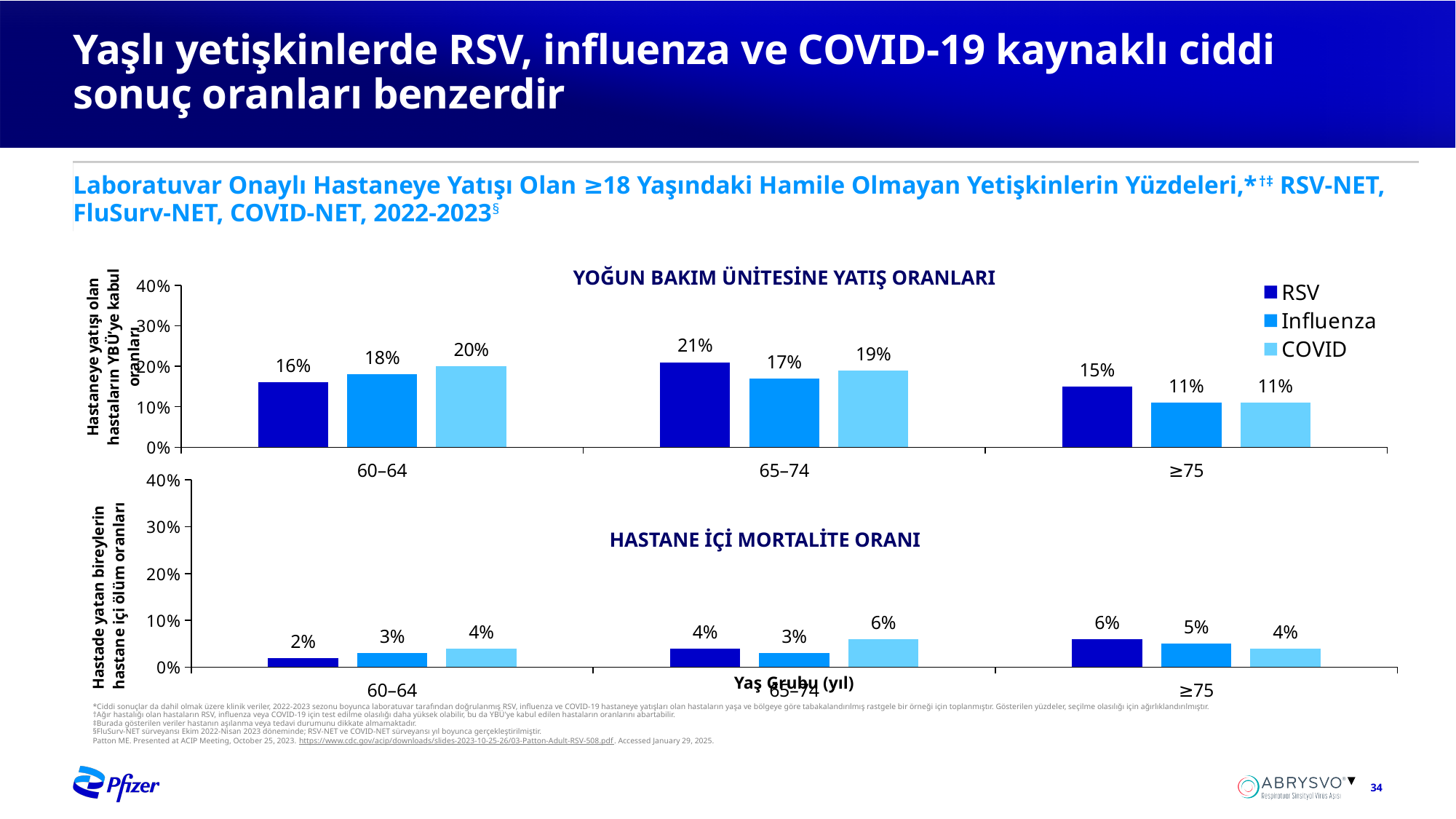
In the 'HASTANE İÇİ MORTALİTE ORANI' chart, which age group has the lowest RSV value? 60–64 What kind of chart is the 'YOĞUN BAKIM ÜNİTESİNE YATIŞ ORANLARI' chart? Bar chart How many series does the legend list for the charts on this slide? 3 In the 'YOĞUN BAKIM ÜNİTESİNE YATIŞ ORANLARI' chart, which age group has the highest RSV value? 65–74 How many age groups are shown on the x axis of the 'HASTANE İÇİ MORTALİTE ORANI' chart? 3 In the 'YOĞUN BAKIM ÜNİTESİNE YATIŞ ORANLARI' chart, what is the RSV value for the 65–74 age group? 21% In the 'HASTANE İÇİ MORTALİTE ORANI' chart, which is larger for the 60–64 age group: the RSV value or the COVID value? COVID In the 'HASTANE İÇİ MORTALİTE ORANI' chart, what is the COVID value for the 65–74 age group? 6% In the 'YOĞUN BAKIM ÜNİTESİNE YATIŞ ORANLARI' chart, what is the difference between the RSV and Influenza values for the ≥75 age group? 4% In the 'YOĞUN BAKIM ÜNİTESİNE YATIŞ ORANLARI' chart, is the Influenza value for the 60–64 age group greater or less than 10%? greater In the 'HASTANE İÇİ MORTALİTE ORANI' chart, what is the RSV value for the ≥75 age group? 6% In the 'YOĞUN BAKIM ÜNİTESİNE YATIŞ ORANLARI' chart, what is the COVID value for the 60–64 age group? 20%